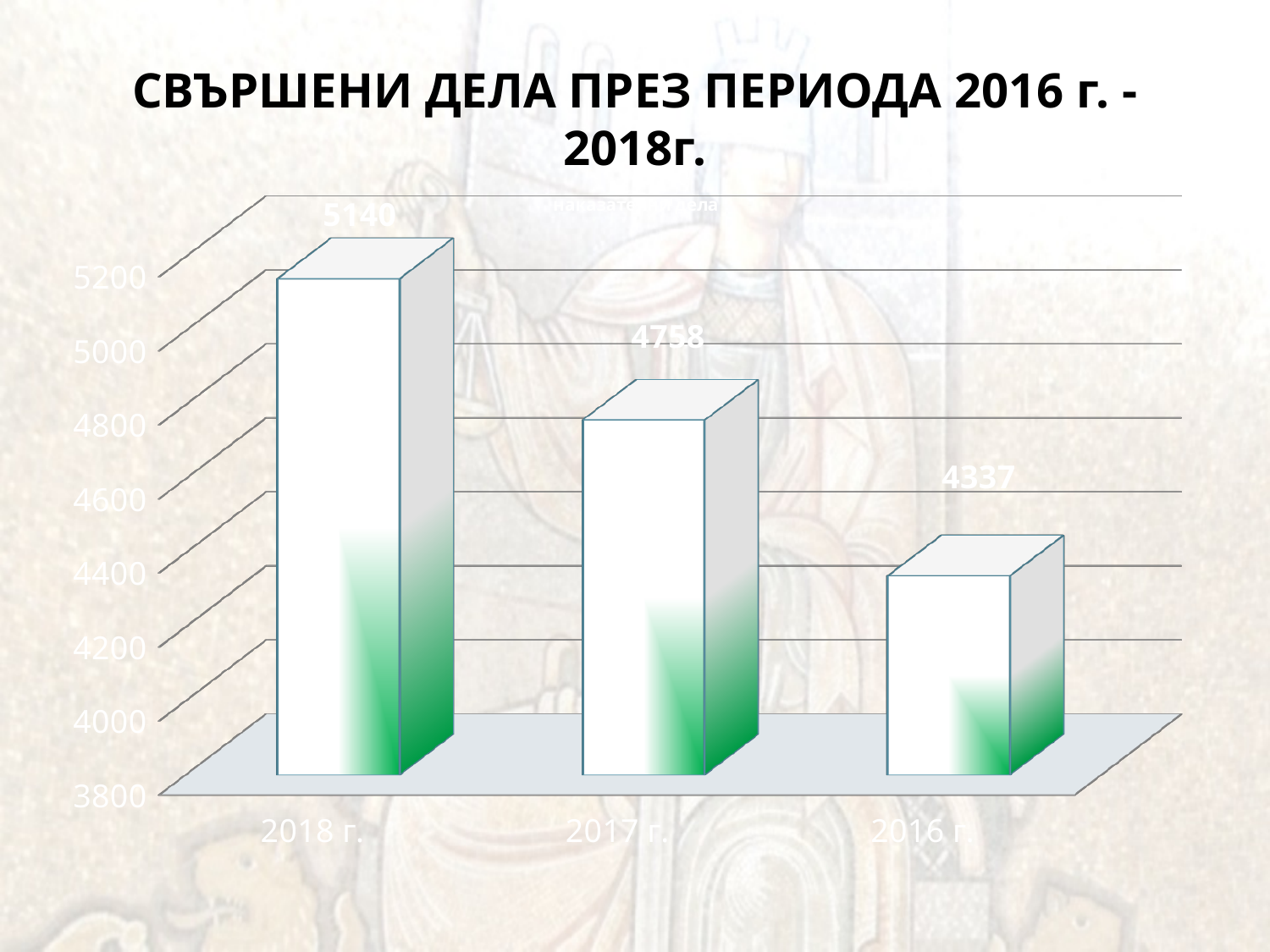
Which year has the highest value? 2018 г. What is the value for 2018 г.? 5140 What is the difference between the values for 2018 г. and 2017 г.? 382 What kind of chart is shown on the slide? bar chart What is the difference between the values for 2017 г. and 2016 г.? 421 What is the value for 2017 г.? 4758 What is the value for 2016 г.? 4337 Do the values rise or fall from left to right along the x axis? fall Is the value for 2016 г. greater or less than 4400? less Which is larger, the value for 2017 г. or the value for 2016 г.? 2017 г. Which year has the lowest value? 2016 г. How many years are shown on the chart? 3